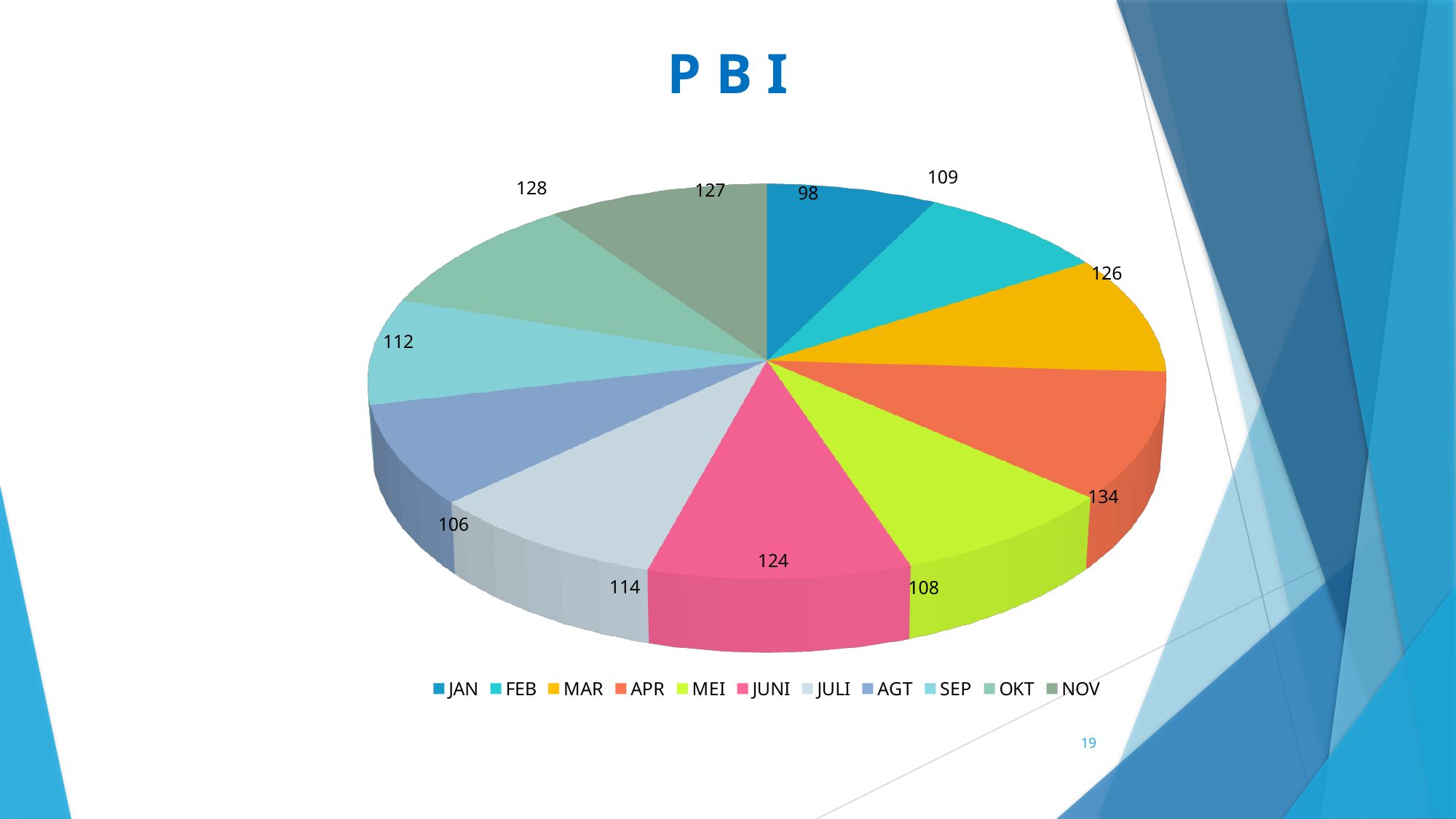
What kind of chart is shown on the slide? Pie chart What is the value for JUNI in the PBI pie chart? 124 What is the difference between the values for OKT and NOV in the PBI pie chart? 1 How many slices does the PBI pie chart have? 11 What is the value for APR in the PBI pie chart? 134 Which month has the largest slice in the PBI pie chart? APR What is the total of all the slice values in the PBI pie chart? 1286 What is the title of the chart on the slide? P B I Which month has the smallest slice in the PBI pie chart? JAN Which is larger in the PBI pie chart, the value for MAR or the value for AGT? MAR What is the value for SEP in the PBI pie chart? 112 What is the difference between the values for APR and JAN in the PBI pie chart? 36